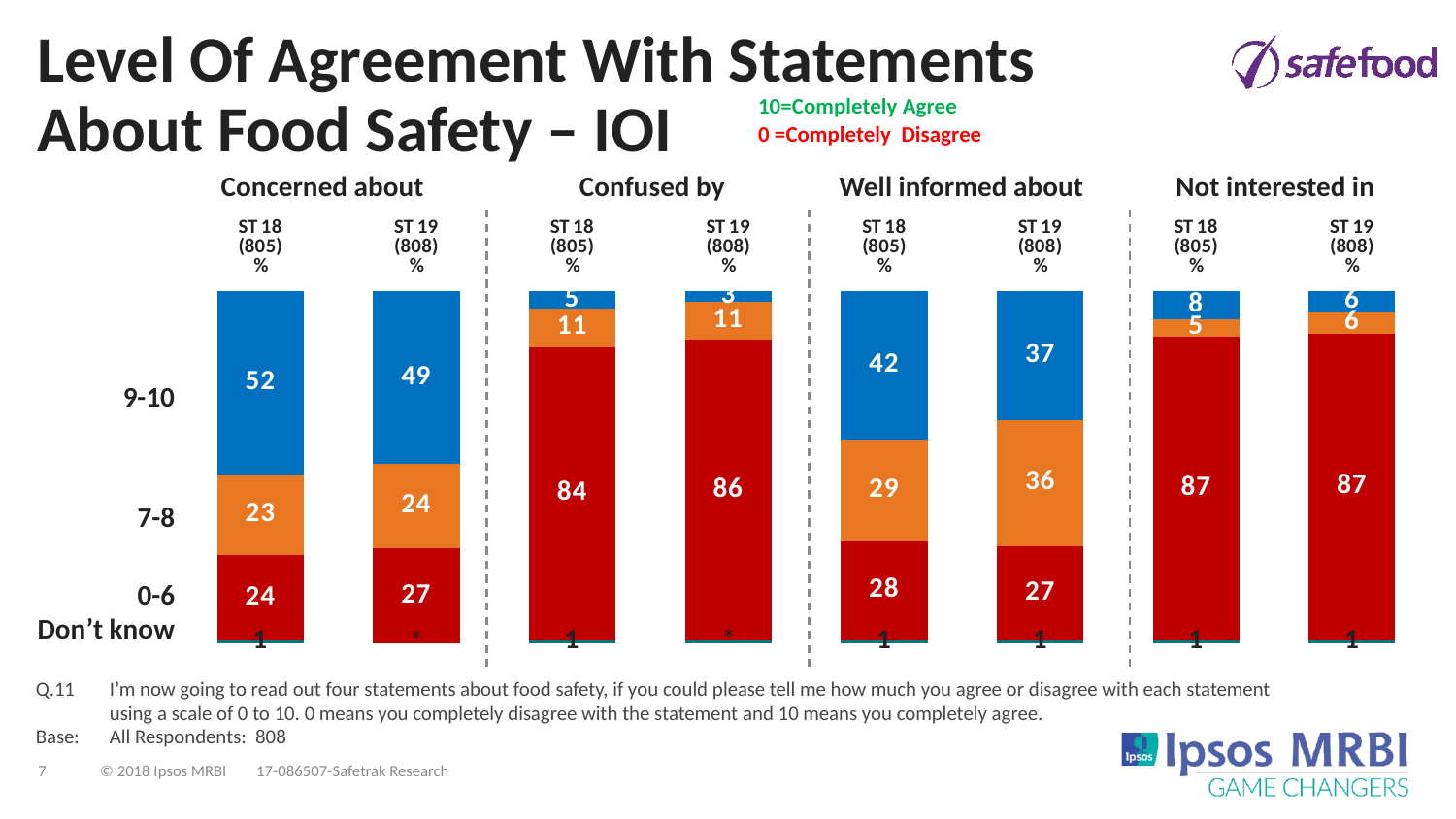
Across the four charts, which statement has the highest 9-10 value for ST 18? Concerned about In the 'Well informed about' chart, what is the value of the 7-8 segment for ST 19? 36 In the 'Confused by' chart, what is the difference between the 9-10 values for ST 18 and ST 19? 2 In the 'Concerned about' chart, what is the difference between the 0-6 values for ST 19 and ST 18? 3 What type of chart is used on this slide? Stacked bar chart In the 'Well informed about' chart, which is larger: the 9-10 value for ST 18 or for ST 19? ST 18 In the 'Concerned about' chart, what is the value of the 9-10 segment for ST 18? 52 How many bars are shown in the 'Not interested in' chart? 2 In the 'Not interested in' chart, what is the value of the 0-6 segment for ST 18? 87 What is the base size shown for ST 19 in the column headers? 808 In the 'Confused by' chart, what is the value of the 0-6 segment for ST 19? 86 Across the four charts, which statement has the lowest 9-10 value for ST 19? Confused by